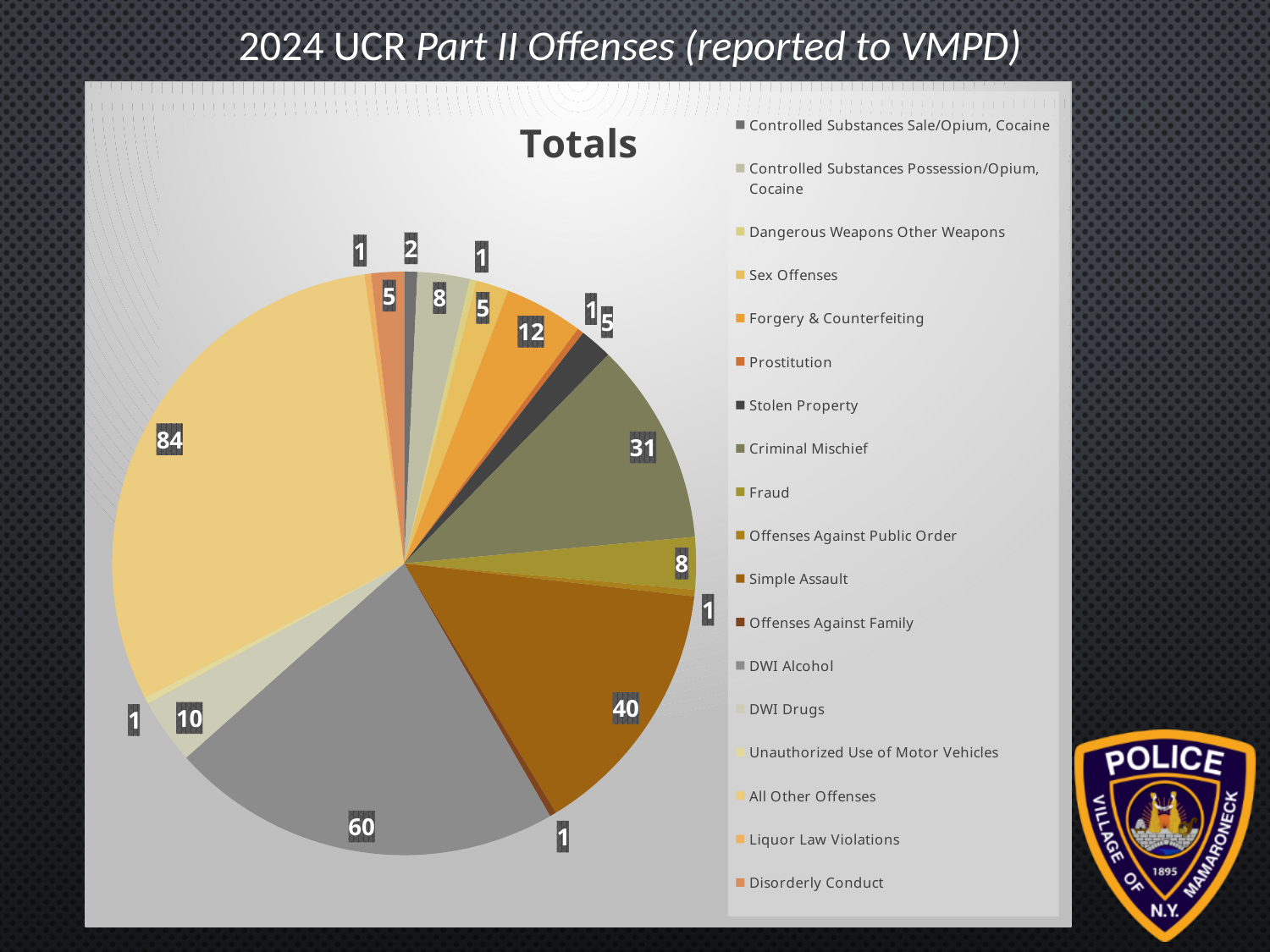
What is the total of all the values shown on the pie chart? 276 What is the value shown for DWI Alcohol? 60 Which is larger, the value for Simple Assault or the value for Criminal Mischief? Simple Assault What kind of chart is shown on the slide? pie chart What is the value shown for Forgery & Counterfeiting? 12 What is the value shown for Criminal Mischief? 31 What is the value shown for Simple Assault? 40 What is the title of the chart? Totals What is the value shown for All Other Offenses? 84 Which category has the largest slice of the pie? All Other Offenses How many categories does the chart's legend list? 18 What is the difference between the values for All Other Offenses and DWI Alcohol? 24